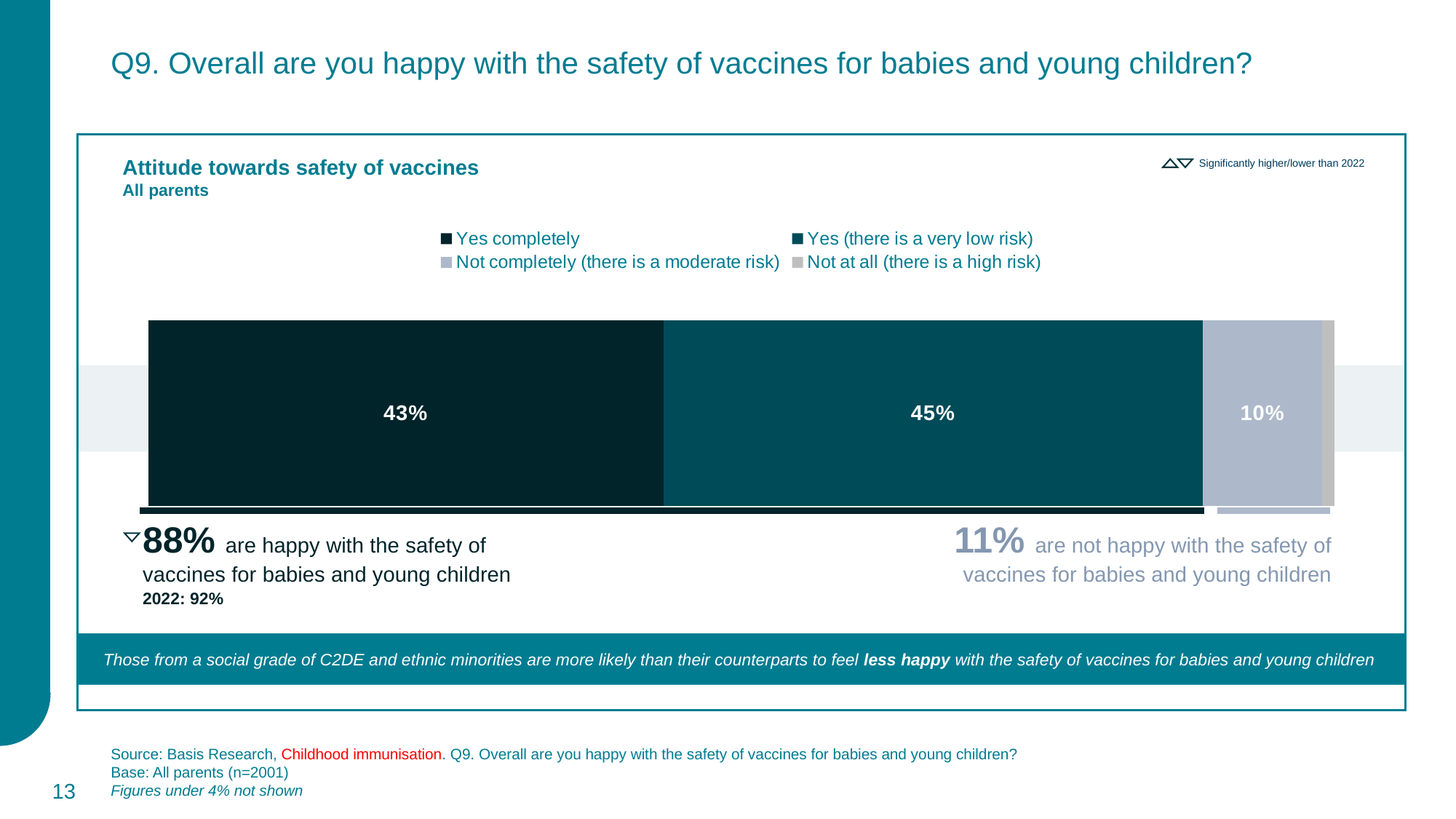
Which response has the largest share in the stacked bar? Yes (there is a very low risk) According to the slide, what percentage of parents are happy with the safety of vaccines for babies and young children? 88% How many response categories does the legend list? 4 What percentage of parents answered 'Yes (there is a very low risk)'? 45% How many bars are plotted in the chart? 1 What percentage of parents answered 'Yes completely' in the Attitude towards safety of vaccines chart? 43% Which response has the smallest share in the stacked bar? Not at all (there is a high risk) What type of chart is shown on the slide? Stacked bar chart What percentage of parents answered 'Not completely (there is a moderate risk)'? 10% What is the title of the chart? Attitude towards safety of vaccines Which is larger: the share for 'Yes completely' or the share for 'Not completely (there is a moderate risk)'? Yes completely What is the difference in percentage points between 'Yes (there is a very low risk)' and 'Yes completely'? 2 percentage points